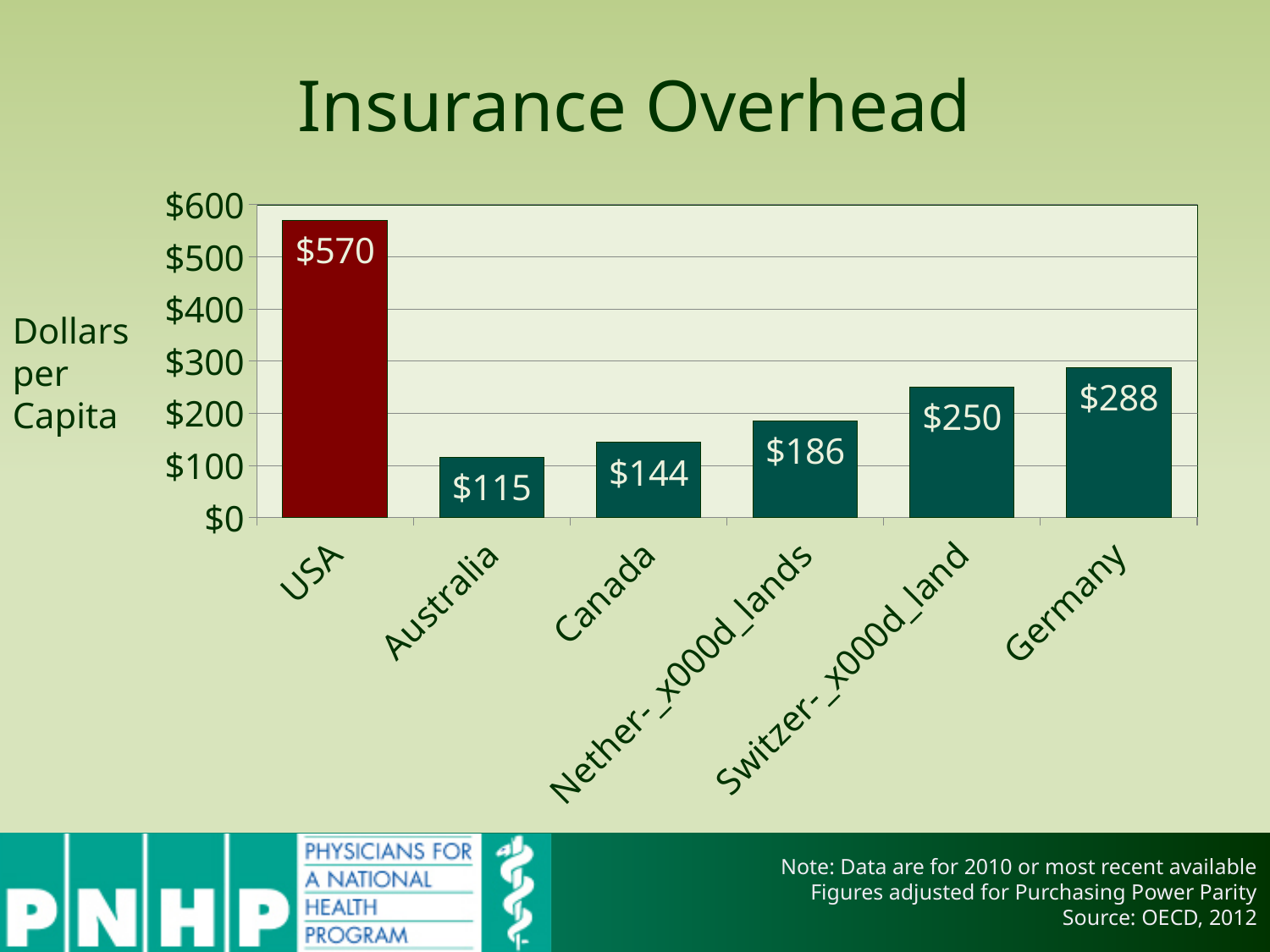
Is the value for Germany greater or less than $200? greater What is the difference in insurance overhead per capita between Switzerland and Canada? $106 Which country has the highest insurance overhead per capita? USA What is the insurance overhead per capita for Australia? $115 Which has a higher insurance overhead per capita, Canada or the Netherlands? Netherlands What is the insurance overhead per capita for Canada? $144 How much higher is the USA's insurance overhead per capita than Germany's? $282 Which country has the lowest insurance overhead per capita? Australia What type of chart is shown on the slide? Bar chart What is the insurance overhead per capita for Germany? $288 What is the insurance overhead per capita for the USA? $570 How many countries are shown in the chart? 6